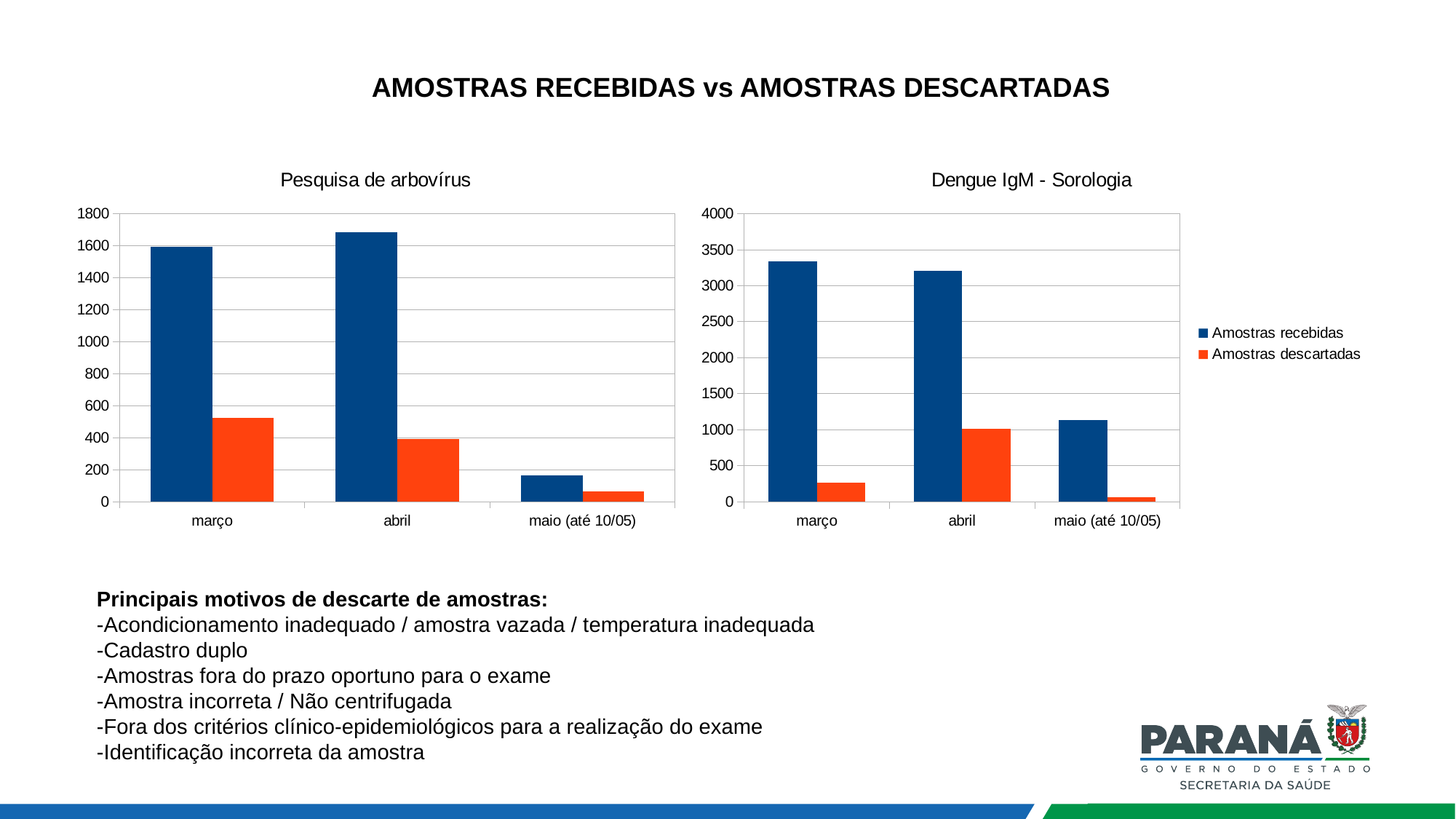
How many series does the legend on the slide list? 2 In the 'Dengue IgM - Sorologia' chart, is the value for Amostras descartadas in março greater or less than 500? less In the 'Dengue IgM - Sorologia' chart, which month has the highest value for Amostras descartadas? abril In the 'Pesquisa de arbovírus' chart, which is larger: Amostras descartadas in março or Amostras descartadas in abril? março In the 'Pesquisa de arbovírus' chart, which month has the highest value for Amostras recebidas? abril In the 'Dengue IgM - Sorologia' chart, does the value for Amostras recebidas rise or fall from abril to maio (até 10/05)? fall How many months are shown on the x axis of the 'Pesquisa de arbovírus' chart? 3 In the 'Pesquisa de arbovírus' chart, is the value for Amostras descartadas in abril greater or less than 600? less In the 'Pesquisa de arbovírus' chart, which month has the lowest value for Amostras descartadas? maio (até 10/05) In the 'Dengue IgM - Sorologia' chart, is the value for Amostras recebidas in março greater or less than 3000? greater In the 'Dengue IgM - Sorologia' chart, which month has the lowest value for Amostras recebidas? maio (até 10/05)